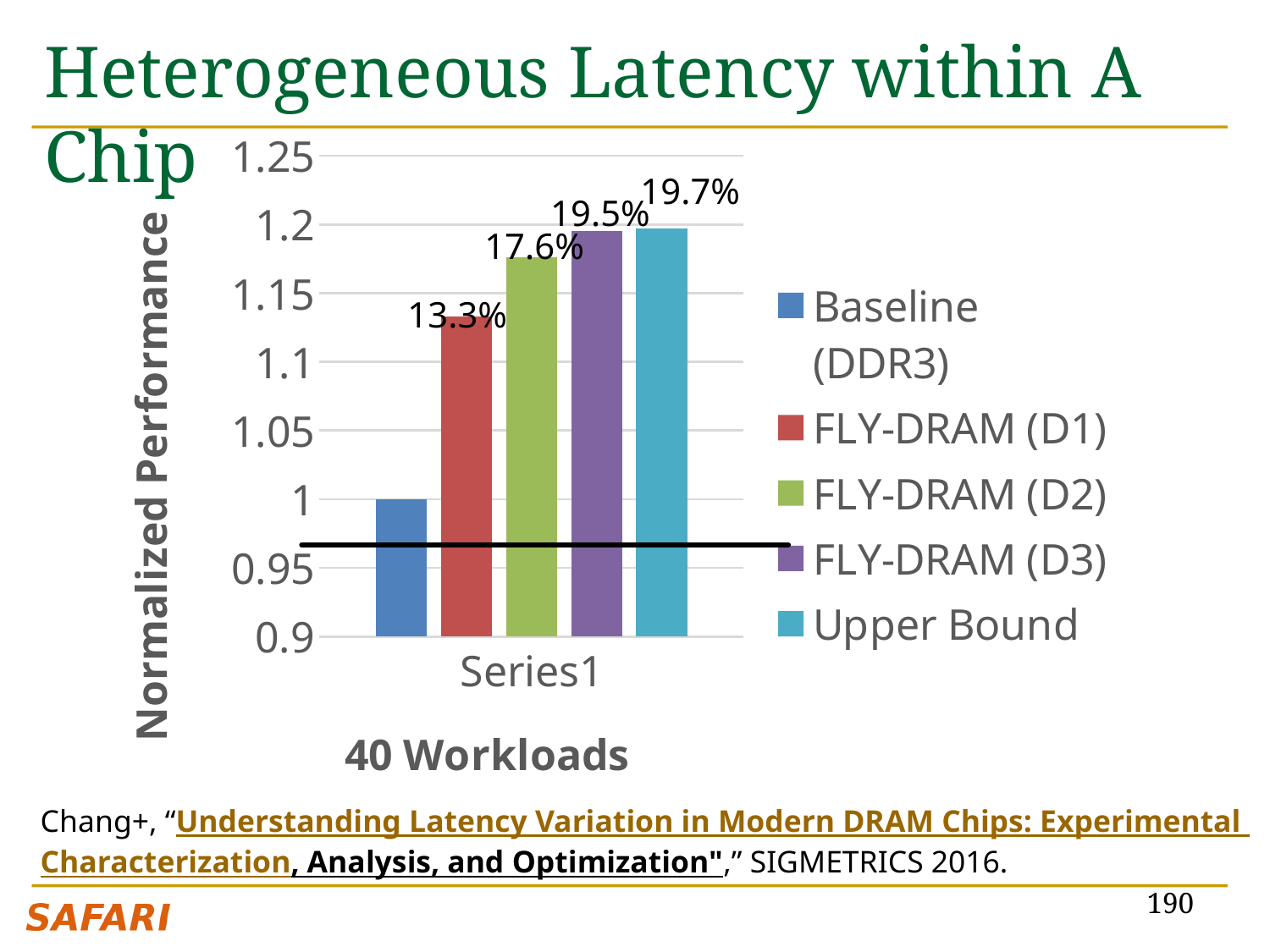
What percentage label is shown on the FLY-DRAM (D2) bar? 17.6% How many series does the legend list? 5 Which series has the shortest bar? Baseline (DDR3) What is the title of the vertical axis? Normalized Performance What kind of chart is shown on the slide? bar chart Is the normalized performance for FLY-DRAM (D1) greater or less than 1.15? less Which series has the tallest bar? Upper Bound What percentage label is shown on the Upper Bound bar? 19.7% Which bar is taller, FLY-DRAM (D1) or FLY-DRAM (D2)? FLY-DRAM (D2) What percentage label is shown on the FLY-DRAM (D3) bar? 19.5% What percentage label is shown on the FLY-DRAM (D1) bar? 13.3% What normalized performance value does the Baseline (DDR3) bar reach? 1